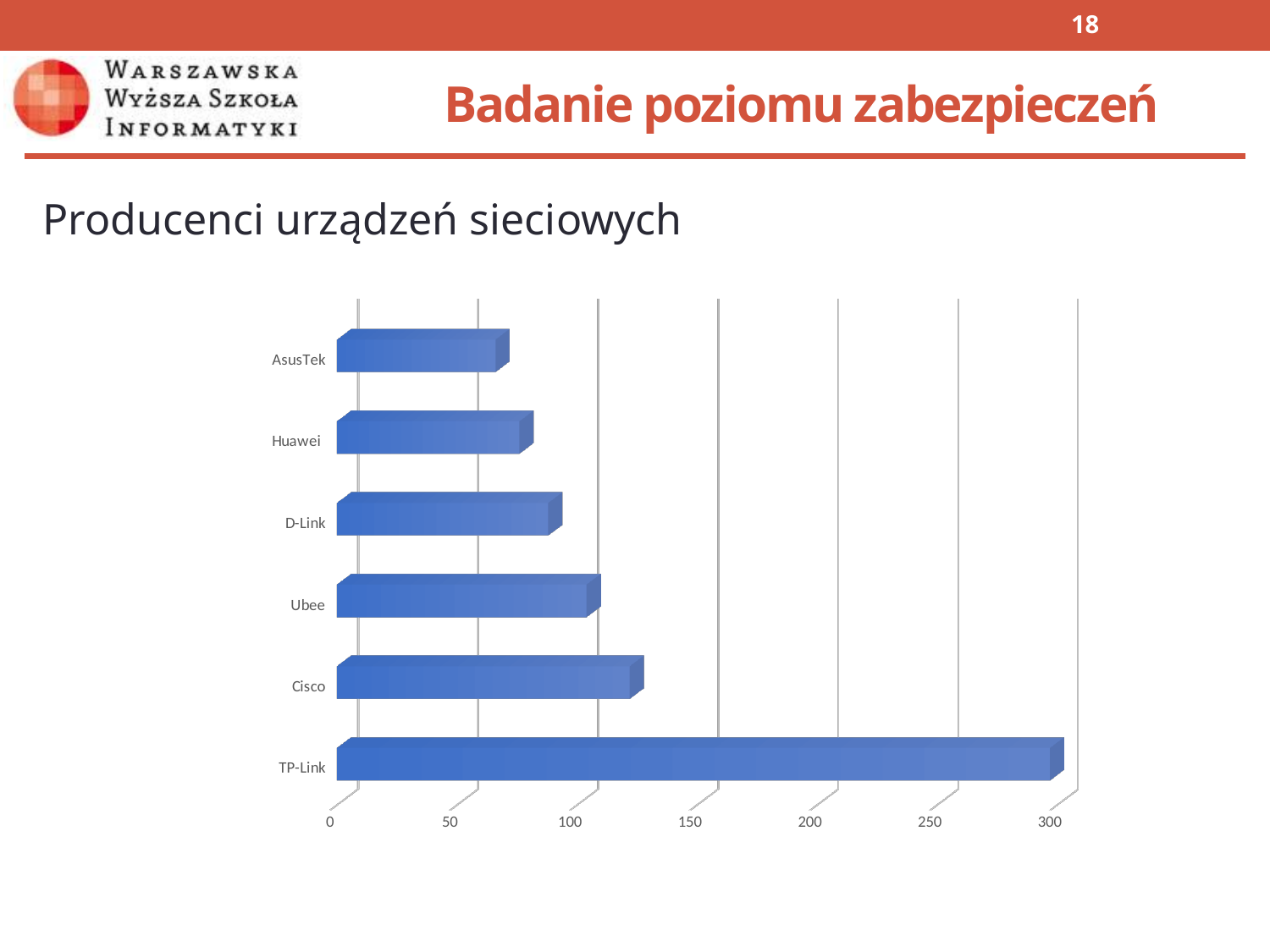
What is the title shown above the chart? Producenci urządzeń sieciowych How many manufacturers (categories) are shown in the chart? 6 Is the value for Huawei greater or less than 100? less Which manufacturer has the highest value in the chart? TP-Link Is the value for AsusTek greater or less than 100? less Is the value for Ubee greater or less than 150? less Which manufacturer has the lowest value in the chart? AsusTek What kind of chart is shown on the slide? Bar chart Which has a larger value, TP-Link or Ubee? TP-Link Which has a larger value, Cisco or Huawei? Cisco